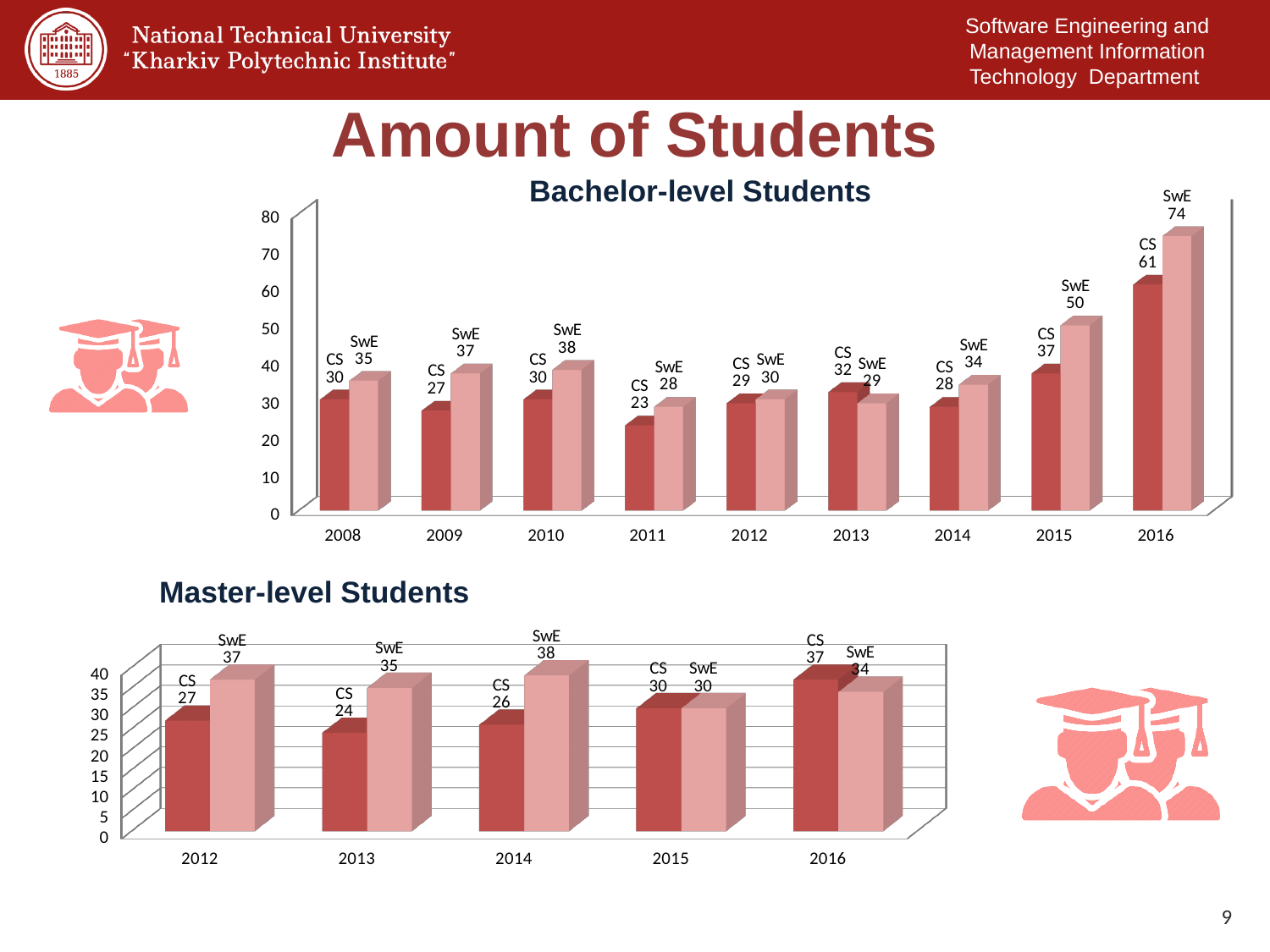
In the Bachelor-level Students chart, what is the difference between the SwE and CS values for 2015? 13 In the Master-level Students chart, which year has the lowest CS value? 2013 In the Master-level Students chart, what is the difference between the SwE and CS values for 2012? 10 In the Master-level Students chart, what is the SwE value for 2014? 38 In the Bachelor-level Students chart, which is larger for 2013, CS or SwE? CS In the Bachelor-level Students chart, what is the SwE value for 2016? 74 In the Bachelor-level Students chart, which year has the highest CS value? 2016 What type of chart is the Master-level Students chart? Bar chart How many years are shown on the x axis of the Bachelor-level Students chart? 9 In the Bachelor-level Students chart, which year has the lowest SwE value? 2011 In the Bachelor-level Students chart, what is the CS value for 2011? 23 How many years are shown on the x axis of the Master-level Students chart? 5